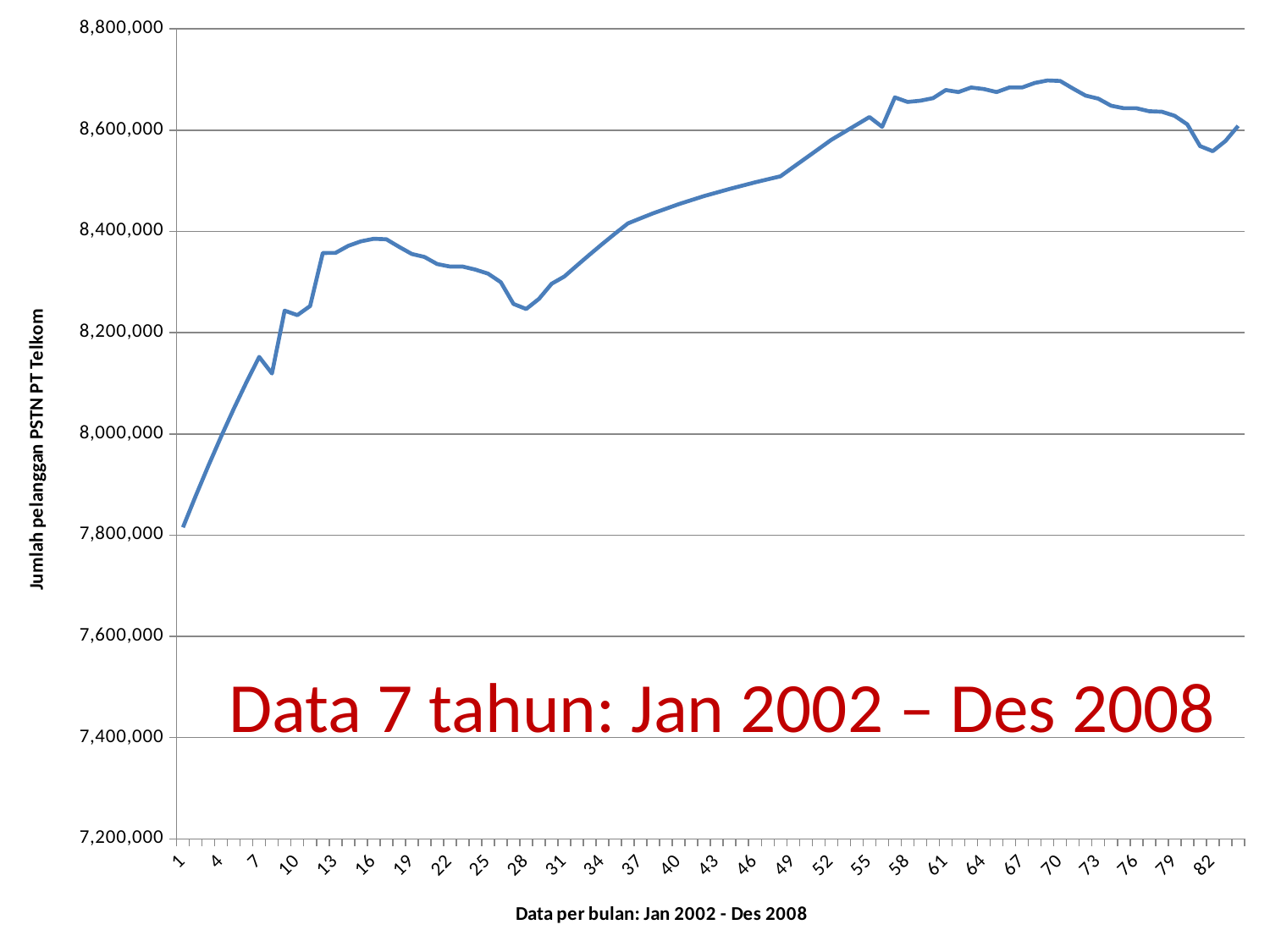
Overall, do the values rise or fall from point 1 to point 70? rise Is the value at point 1 greater or less than 8,000,000? less What is the title of the vertical axis? Jumlah pelanggan PSTN PT Telkom Is the value at point 40 greater or less than 8,400,000? greater Is the value at point 70 greater or less than 8,600,000? greater What kind of chart is shown on the slide? line chart Do the values rise or fall between point 70 and point 82? fall Which is larger, the value at point 16 or the value at point 28? point 16 What is the title of the horizontal axis? Data per bulan: Jan 2002 - Des 2008 At which x-axis point is the lowest value on the line? 1